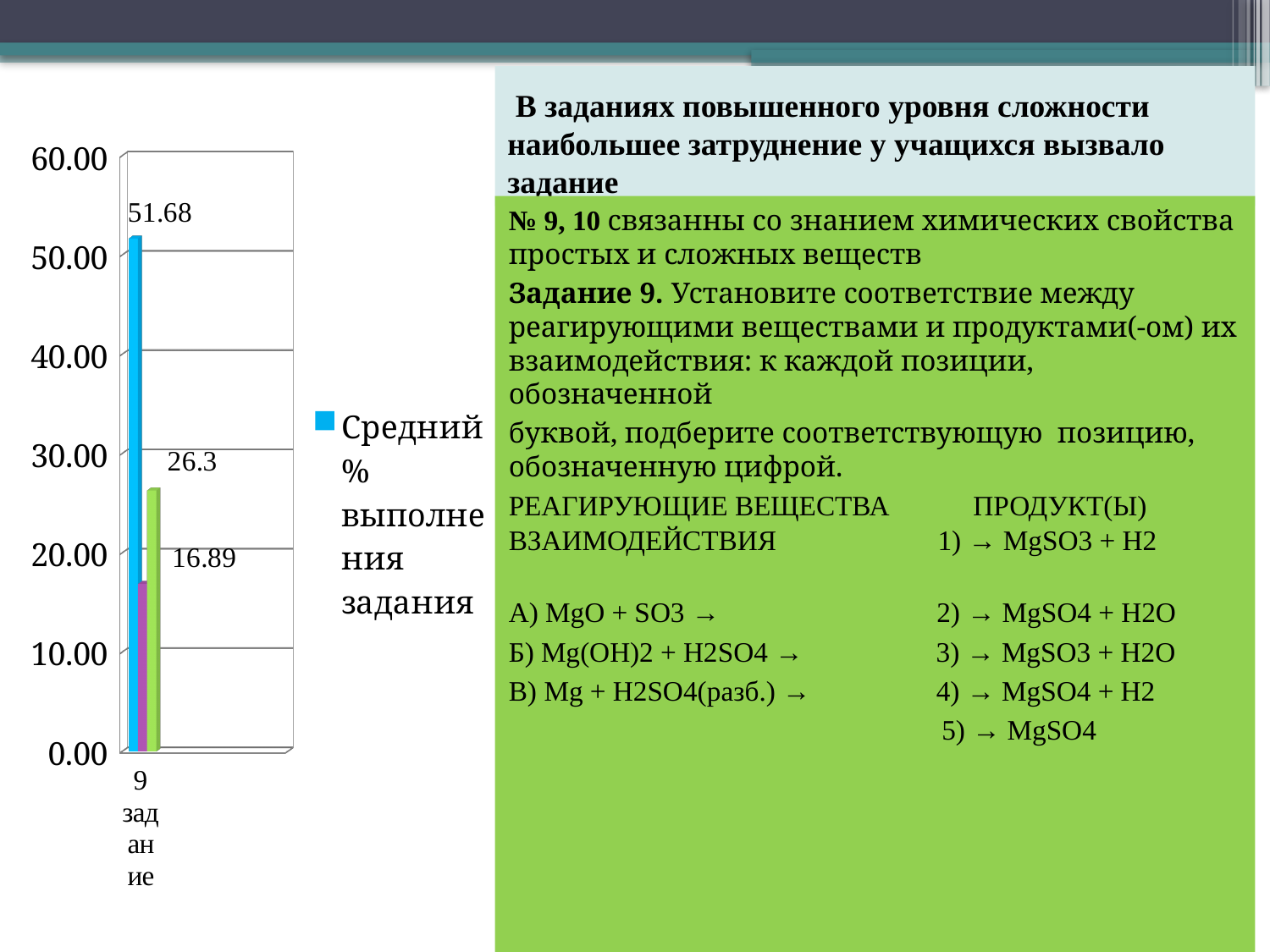
What is the lowest value labelled on the chart? 16.89 Which bar is taller in the chart, the blue bar or the green bar? the blue bar What is the difference between the values 26.3 and 16.89 shown on the chart? 9.41 What kind of chart is shown on the left of the slide? bar chart What is the category label shown on the x axis of the chart? 9 задание What is the difference between the highest labelled value (51.68) and the lowest labelled value (16.89) on the chart? 34.79 What is the value of the purple bar in the chart? 16.89 Is the value of the blue bar greater or less than 50.00? greater What is the value of the blue bar in the chart? 51.68 What is the value of the green bar in the chart? 26.3 What is the highest value labelled on the chart? 51.68 How many categories are shown on the x axis of the chart? 1